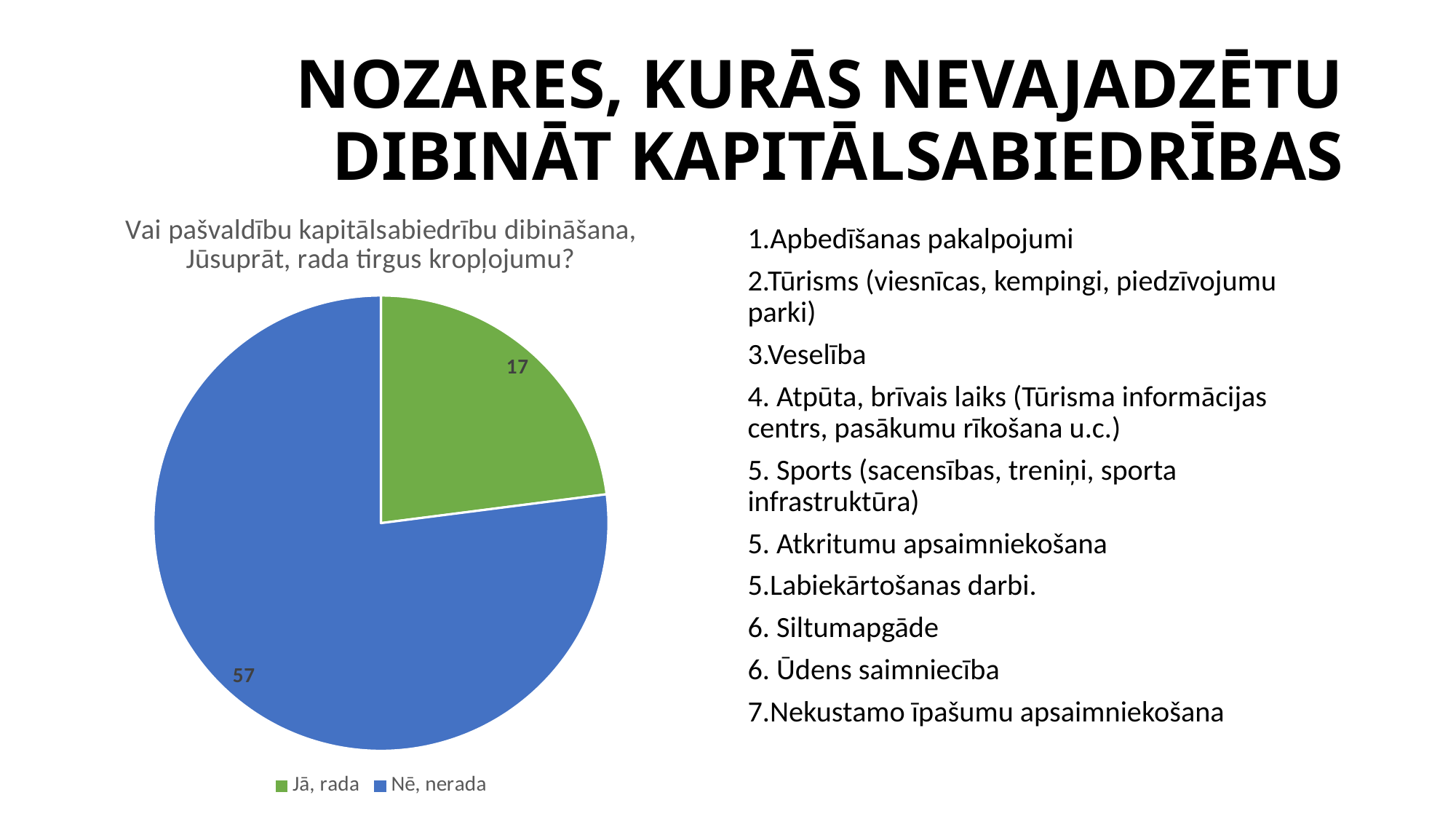
What is the difference between the values for "Nē, nerada" and "Jā, rada"? 40 How many entries does the legend of the pie chart list? 2 Which category has the smallest slice in the pie chart? Jā, rada What is the value for "Nē, nerada" in the pie chart? 57 What is the total of the two values shown in the pie chart? 74 What kind of chart is shown on the slide? pie chart What is the value for "Jā, rada" in the pie chart? 17 What colour is the "Nē, nerada" slice in the pie chart? blue What share of the pie does "Jā, rada" represent, to the nearest whole percent? 23% Which category has the largest slice in the pie chart? Nē, nerada Which is larger, the value for "Jā, rada" or the value for "Nē, nerada"? Nē, nerada How many slices does the pie chart have? 2